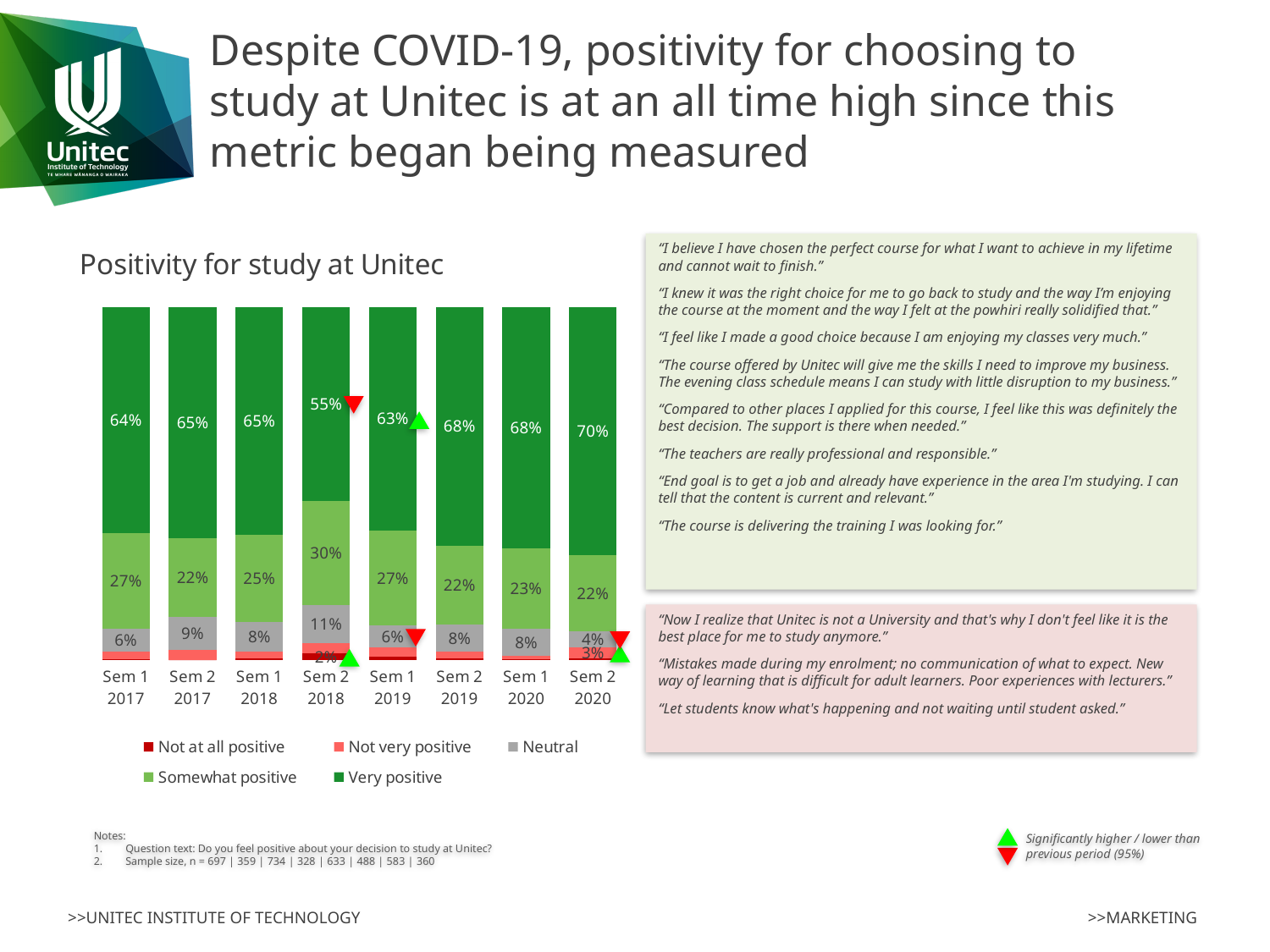
Which semester has the highest Very positive value? Sem 2 2020 Which semester has the lowest Very positive value? Sem 2 2018 What is the Very positive value for Sem 2 2020? 70% What is the title of the chart on the slide? Positivity for study at Unitec What is the Neutral value for Sem 2 2017? 9% What is the difference between the Very positive values for Sem 2 2020 and Sem 2 2018? 15% Which is larger, the Neutral value for Sem 2 2018 or for Sem 2 2020? Sem 2 2018 What is the Not very positive value for Sem 2 2020? 3% What type of chart is shown on the slide? Stacked bar chart How many semesters (categories) are shown on the x axis of the chart? 8 How many series does the chart legend list? 5 What is the Somewhat positive value for Sem 2 2018? 30%